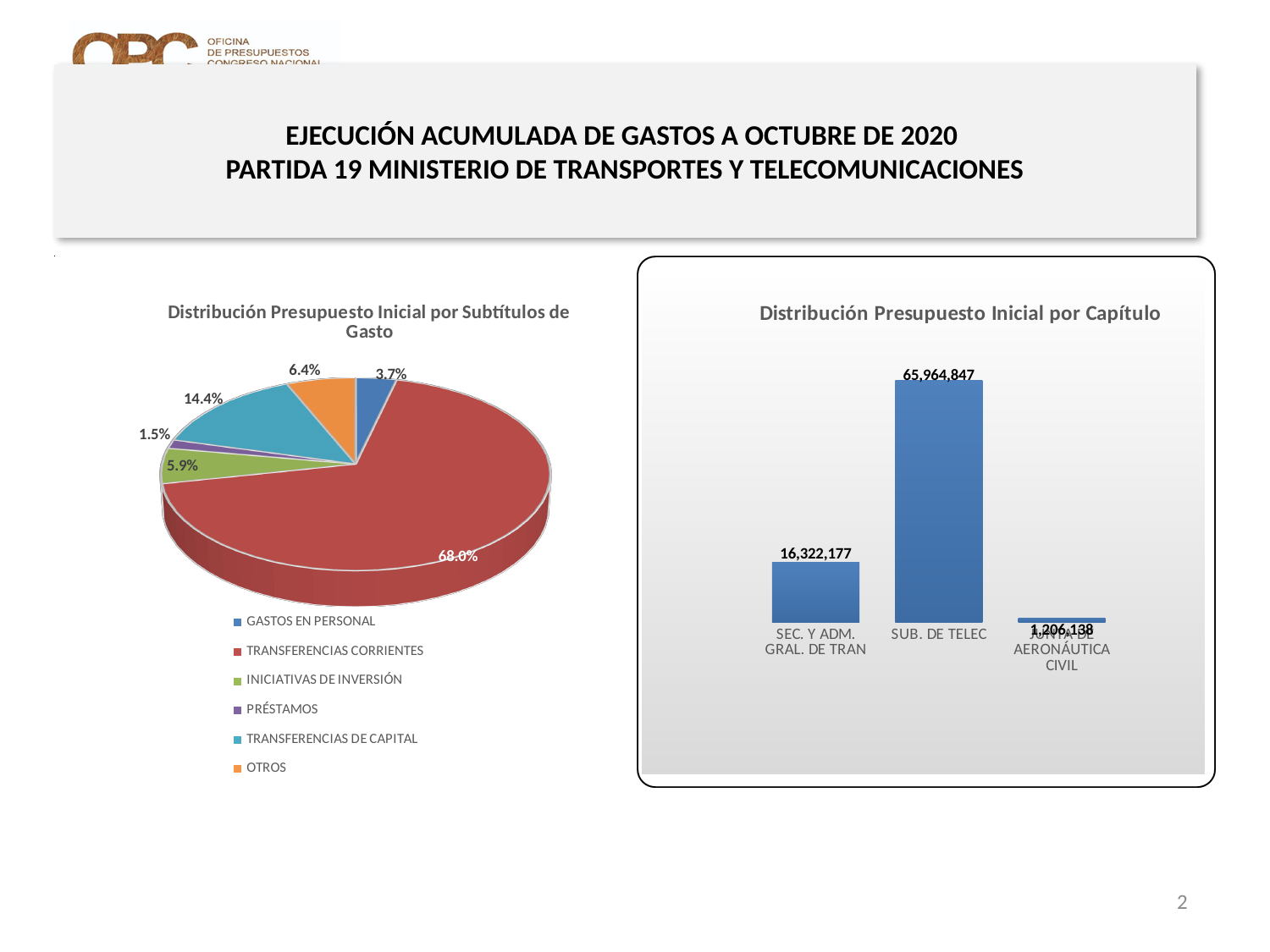
In the 'Distribución Presupuesto Inicial por Subtítulos de Gasto' pie chart, what share does TRANSFERENCIAS DE CAPITAL have? 14.4% In the 'Distribución Presupuesto Inicial por Subtítulos de Gasto' pie chart, which category has the smallest slice? PRÉSTAMOS In the 'Distribución Presupuesto Inicial por Subtítulos de Gasto' pie chart, which is larger: OTROS or GASTOS EN PERSONAL? OTROS In the 'Distribución Presupuesto Inicial por Capítulo' chart, which category has the lowest value? JUNTA DE AERONÁUTICA CIVIL In the 'Distribución Presupuesto Inicial por Capítulo' chart, which category has the highest value? SUB. DE TELEC In the 'Distribución Presupuesto Inicial por Subtítulos de Gasto' pie chart, what share does TRANSFERENCIAS CORRIENTES have? 68.0% How many categories are shown in the 'Distribución Presupuesto Inicial por Capítulo' chart? 3 What kind of chart is 'Distribución Presupuesto Inicial por Capítulo'? Bar chart In the 'Distribución Presupuesto Inicial por Capítulo' chart, what is the difference between SUB. DE TELEC and SEC. Y ADM. GRAL. DE TRAN? 49,642,670 How many entries does the legend of the 'Distribución Presupuesto Inicial por Subtítulos de Gasto' pie chart list? 6 In the 'Distribución Presupuesto Inicial por Capítulo' chart, what is the value for SUB. DE TELEC? 65,964,847 In the 'Distribución Presupuesto Inicial por Capítulo' chart, what is the value for SEC. Y ADM. GRAL. DE TRAN? 16,322,177